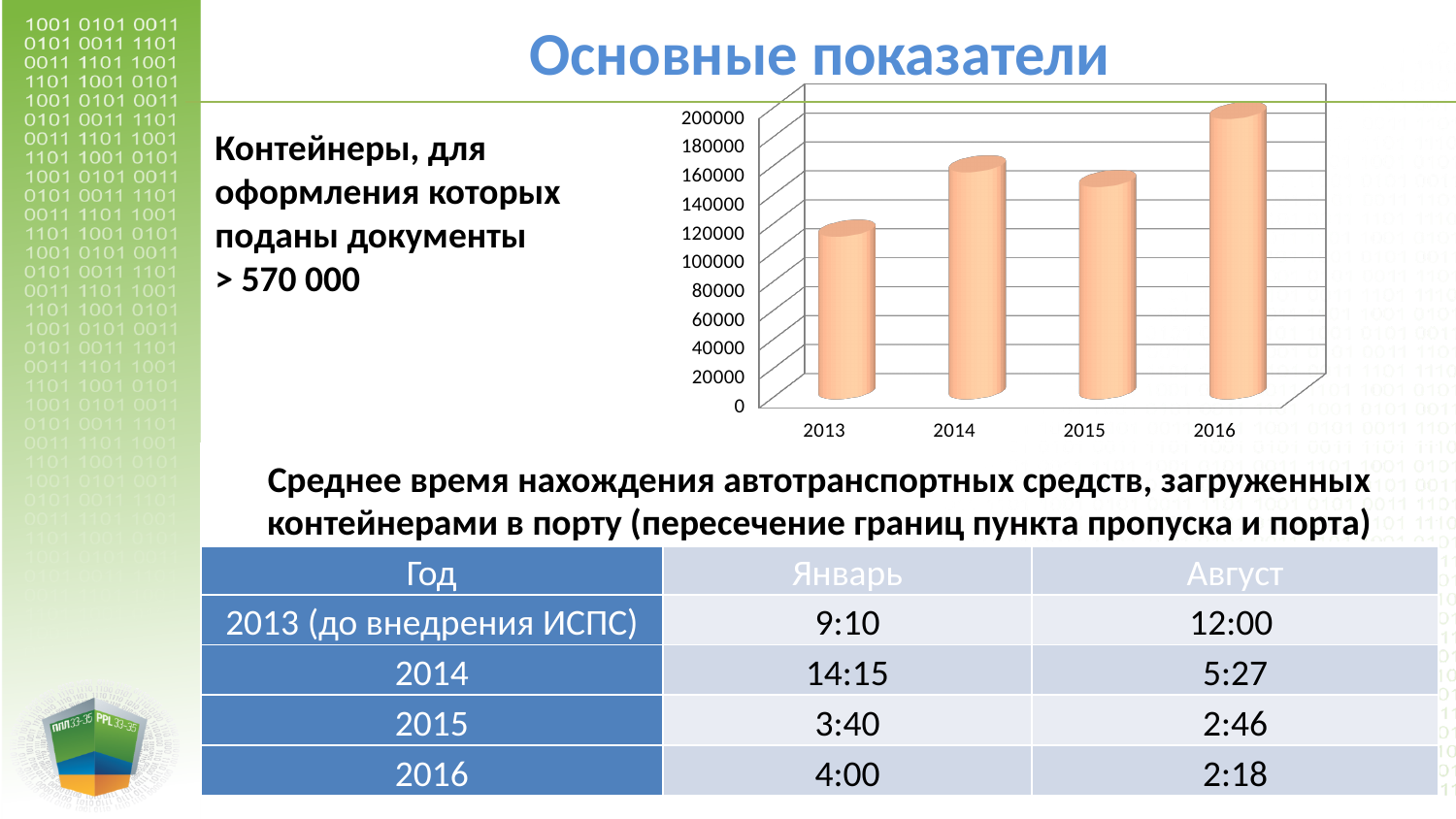
Which year has the larger value on the chart, 2014 or 2015? 2014 How many years are plotted on the chart? 4 Which year has the larger value on the chart, 2013 or 2016? 2016 Is the value for 2015 greater or less than 120000? greater What kind of chart is shown on the slide? bar chart Which year has the lowest bar on the chart? 2013 Is the value for 2013 greater or less than 100000? greater Which year has the highest bar on the chart? 2016 Is the value for 2016 greater or less than 180000? greater What is the highest value shown on the chart's vertical axis? 200000